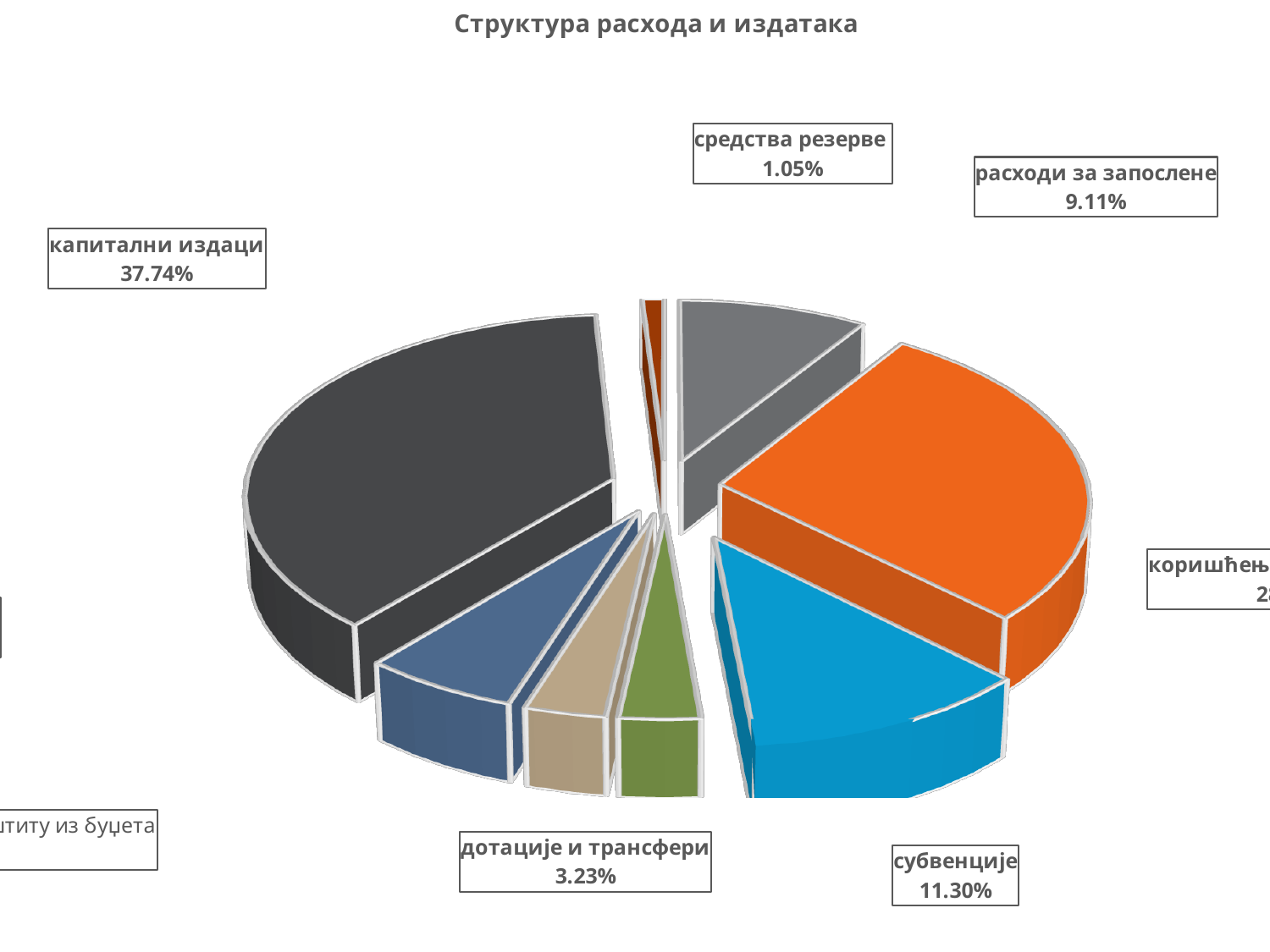
What share does расходи за запослене have in the pie? 9.11% Which category has the smallest slice of the pie? средства резерве What share does субвенције have in the pie? 11.30% What is the difference in percentage points between капитални издаци and субвенције? 26.44 Which is larger, the share for субвенције or the share for расходи за запослене? субвенције What is the title of the chart? Структура расхода и издатака Which category has the largest slice of the pie? капитални издаци What share does дотације и трансфери have in the pie? 3.23% What kind of chart is shown on the slide? pie chart What share does средства резерве have in the pie? 1.05% What share does капитални издаци have in the pie? 37.74% What is the difference in percentage points between субвенције and расходи за запослене? 2.19